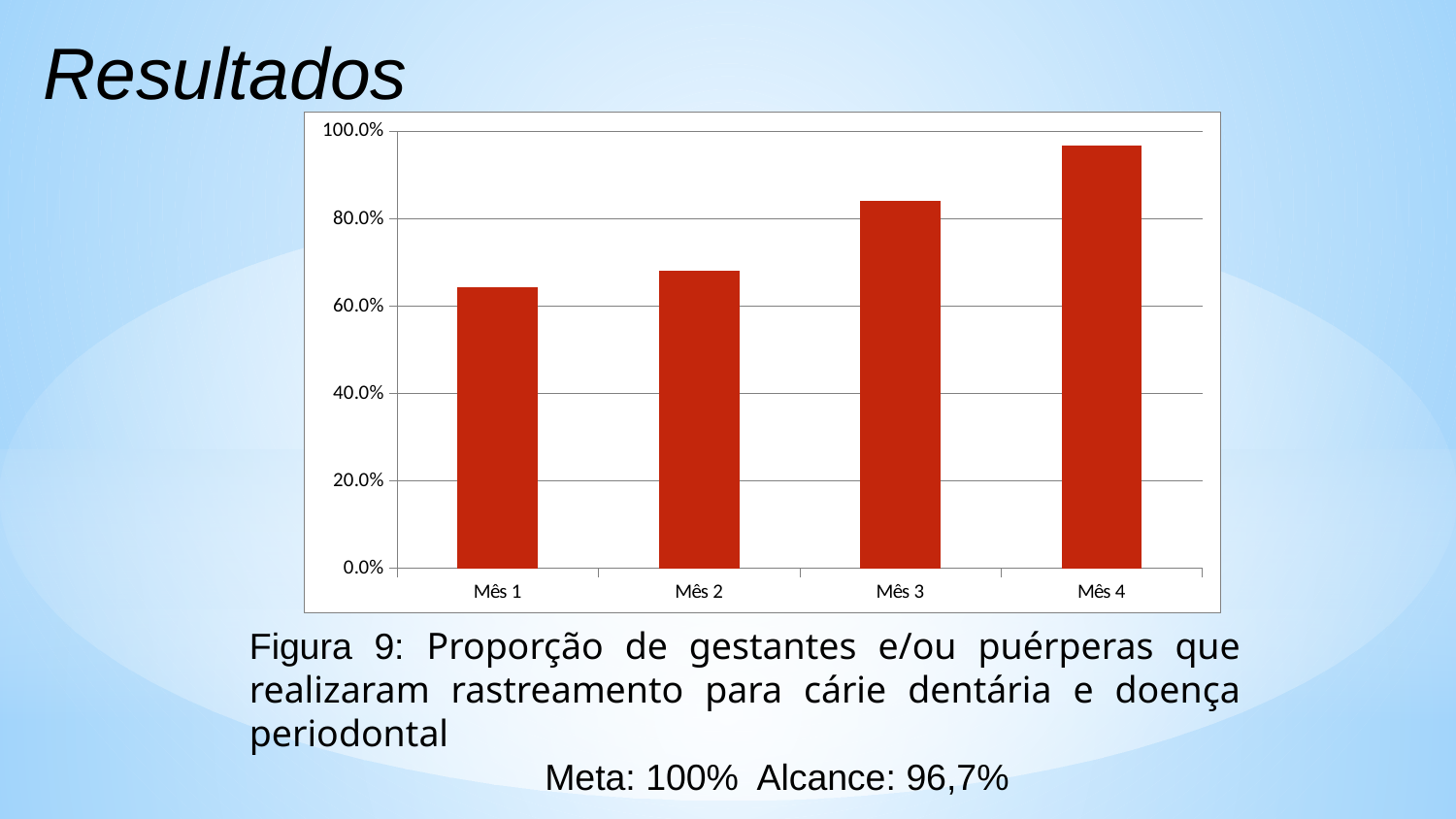
Which is larger, the value for Mês 3 or the value for Mês 2? Mês 3 Which month has the highest bar? Mês 4 What is the 'Alcance' value stated below the chart? 96,7% Is the value for Mês 1 greater or less than 60.0%? greater Is the value for Mês 3 greater or less than 80.0%? greater What is the 'Meta' (target) stated below the chart? 100% Which month has the lowest bar? Mês 1 How many categories (months) are plotted on the x axis? 4 Is the value for Mês 2 greater or less than 80.0%? less What kind of chart is shown on the slide? bar chart Do the values rise or fall from Mês 1 to Mês 4? rise